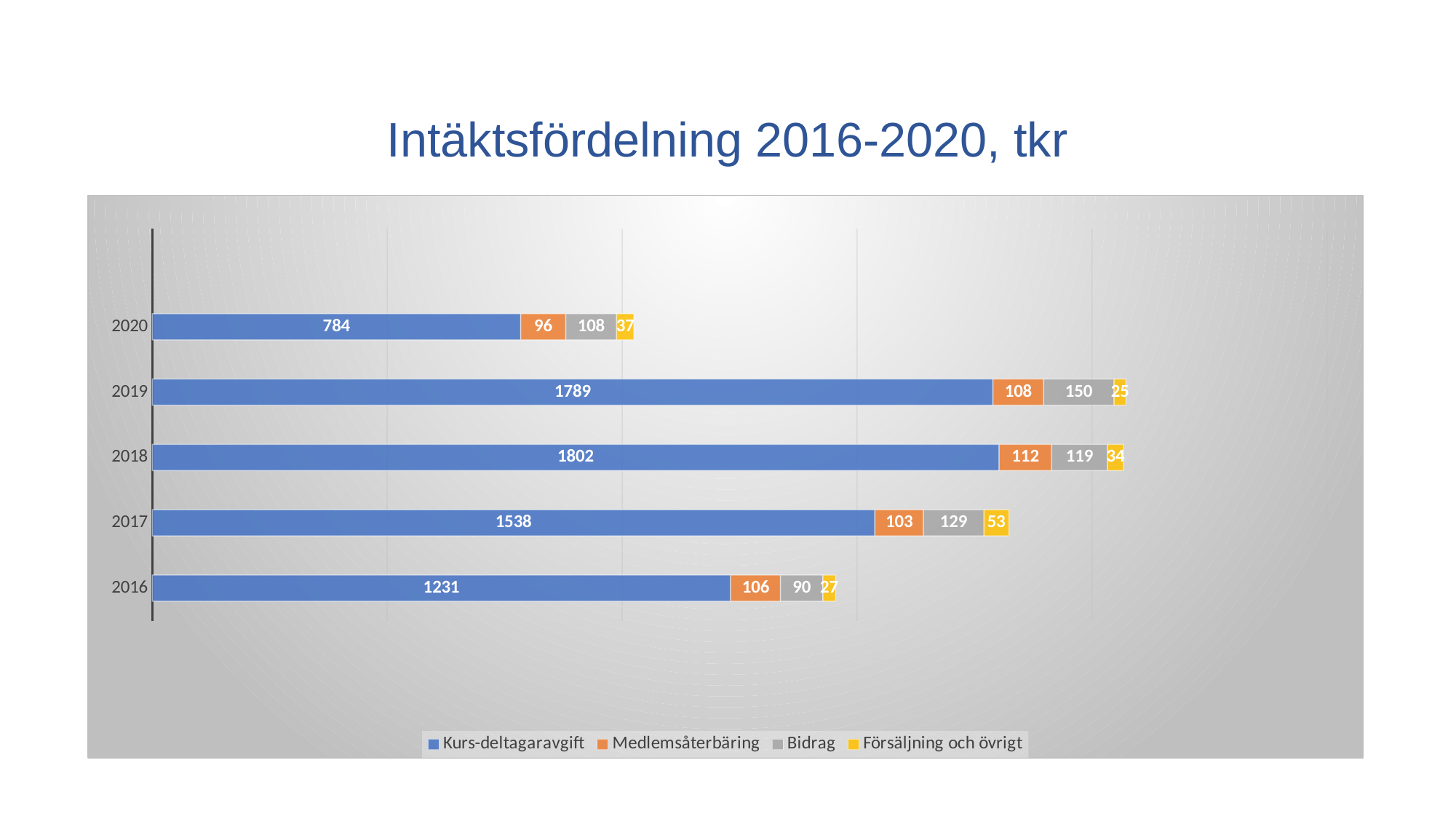
What is the title of the chart? Intäktsfördelning 2016-2020, tkr Which year has the lowest value for Försäljning och övrigt? 2019 What is the value of Kurs-deltagaravgift for 2020? 784 Which is larger, Bidrag for 2017 or Bidrag for 2018? Bidrag for 2017 What is the value of Bidrag for 2019? 150 How many series does the legend list? 4 What is the difference between the Medlemsåterbäring values for 2018 and 2020? 16 What type of chart is shown on the slide? Stacked bar chart What is the total of the stacked bar for 2016? 1454 Which year has the highest value for Kurs-deltagaravgift? 2018 How many years are shown on the chart? 5 What is the value of Försäljning och övrigt for 2017? 53